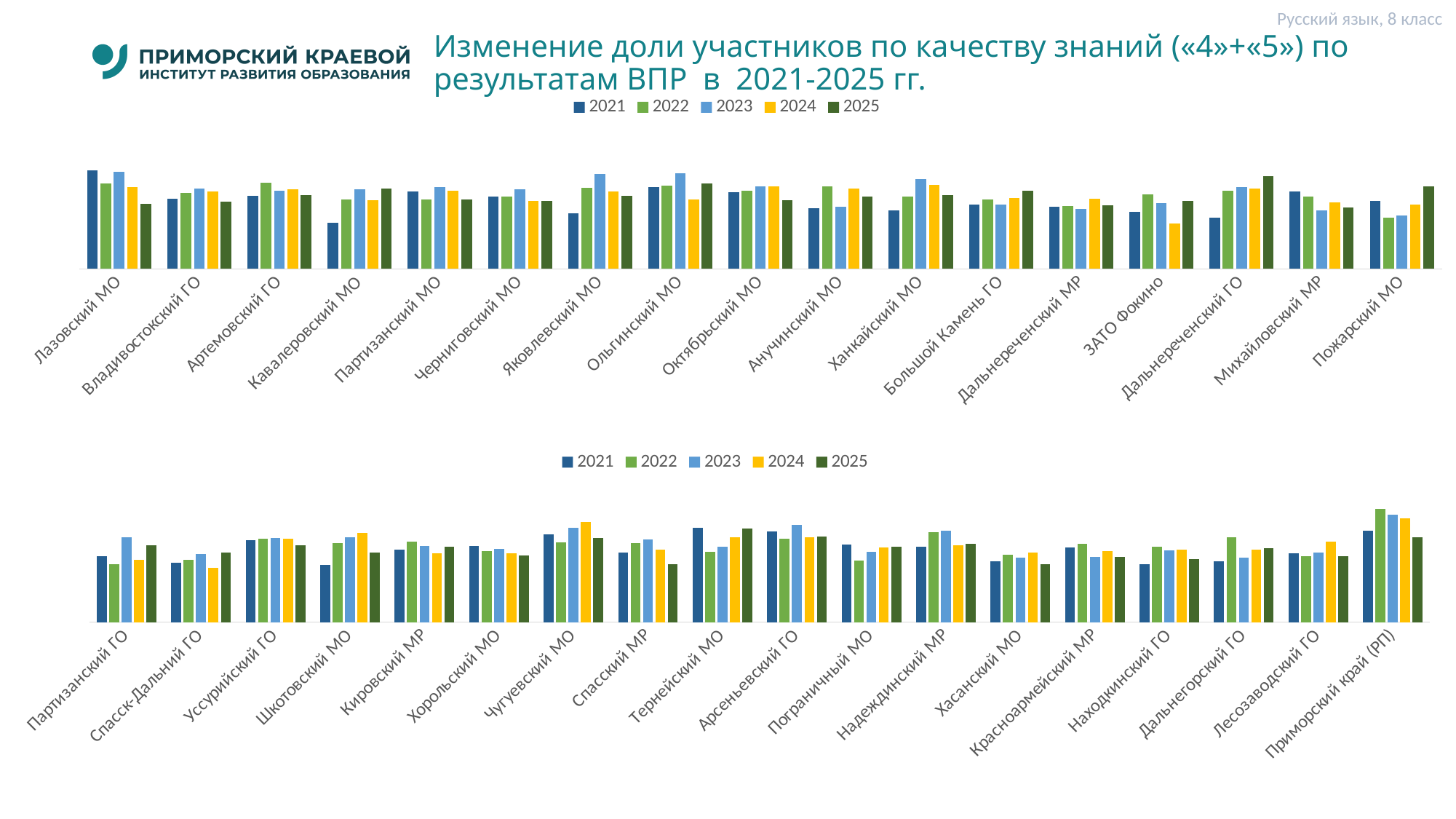
In the bottom chart, which year has the highest value for Приморский край (РП)? 2022 What kind of chart is the top chart on the slide? bar chart Which colour represents the 2024 series in the legend of the charts? yellow In the top chart, which year has the highest value for Яковлевский МО? 2023 In the bottom chart, for Дальнегорский ГО, which is larger: the value for 2022 or the value for 2023? 2022 In the top chart, which year has the lowest value for ЗАТО Фокино? 2024 In the top chart, for Кавалеровский МО, which is larger: the value for 2021 or the value for 2023? 2023 In the bottom chart, which year has the lowest value for Спасский МР? 2025 How many categories are shown on the x axis of the bottom chart? 18 How many categories are shown on the x axis of the top chart? 17 In the top chart, does the value for Лазовский МО rise or fall from 2023 to 2025? fall How many series does the legend of the top chart list? 5